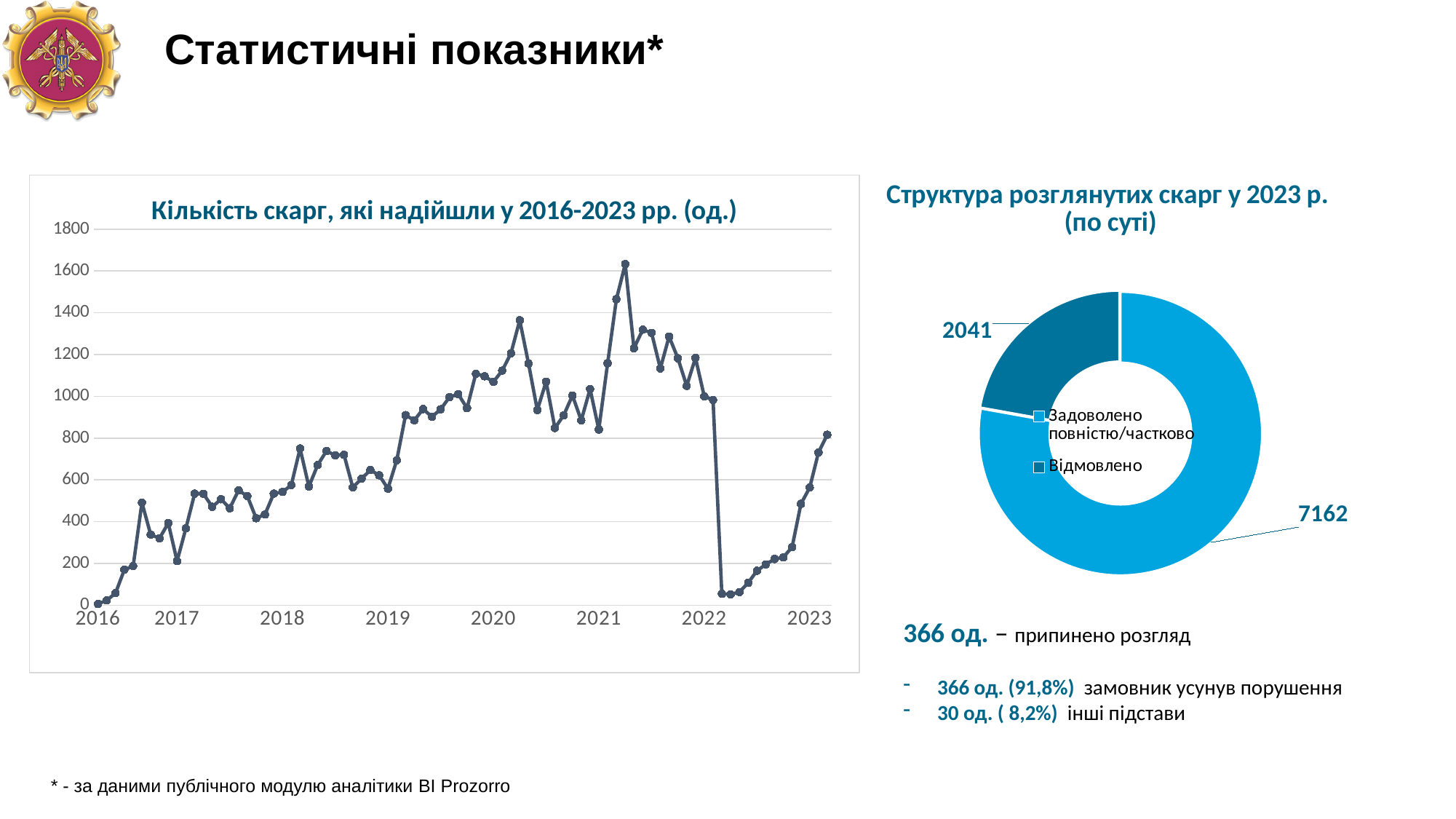
What kind of chart is 'Кількість скарг, які надійшли у 2016-2023 рр. (од.)'? Line chart In the line chart 'Кількість скарг, які надійшли у 2016-2023 рр. (од.)', in which year does the line reach its highest peak? 2021 In the doughnut chart 'Структура розглянутих скарг у 2023 р. (по суті)', which category has the larger value? Задоволено повністю/частково In the doughnut chart 'Структура розглянутих скарг у 2023 р. (по суті)', what is the value for 'Відмовлено'? 2041 In the line chart 'Кількість скарг, які надійшли у 2016-2023 рр. (од.)', is the highest point in 2021 greater or less than 1400? greater In the doughnut chart 'Структура розглянутих скарг у 2023 р. (по суті)', what is the value for 'Задоволено повністю/частково'? 7162 In the line chart 'Кількість скарг, які надійшли у 2016-2023 рр. (од.)', is the value at the start of 2016 greater or less than 200? less In the doughnut chart 'Структура розглянутих скарг у 2023 р. (по суті)', what is the total of the two values shown? 9203 In the line chart 'Кількість скарг, які надійшли у 2016-2023 рр. (од.)', what is the highest value shown on the vertical axis? 1800 In the doughnut chart 'Структура розглянутих скарг у 2023 р. (по суті)', what is the difference between the two values? 5121 What kind of chart is 'Структура розглянутих скарг у 2023 р. (по суті)'? Doughnut chart In the doughnut chart 'Структура розглянутих скарг у 2023 р. (по суті)', how many categories does the legend list? 2